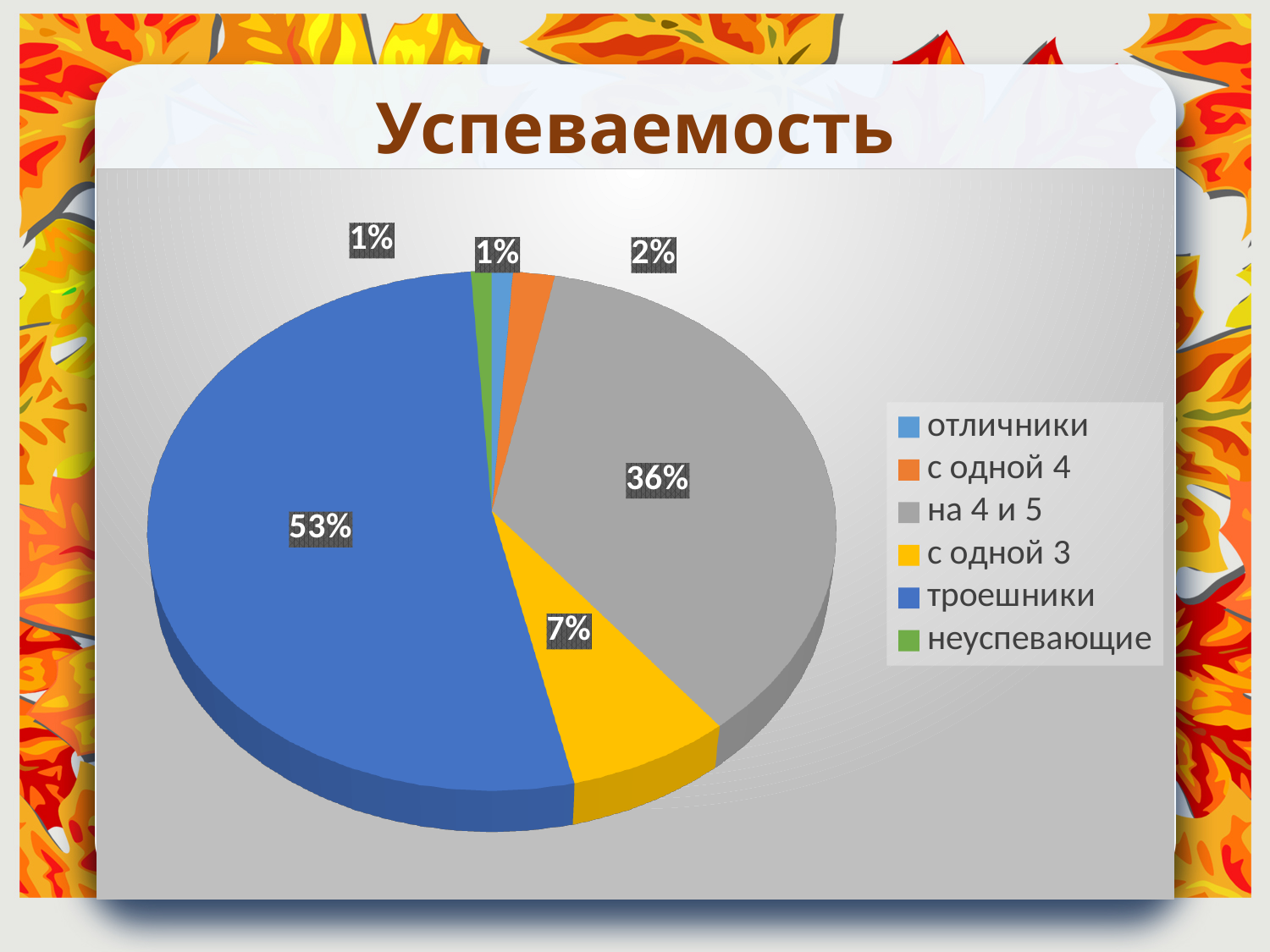
What share of the pie is "отличники"? 1% What share of the pie is "троешники"? 53% What share of the pie is "с одной 3"? 7% Which is larger, the slice for "на 4 и 5" or the slice for "с одной 3"? на 4 и 5 What is the difference between the shares of "троешники" and "на 4 и 5"? 17% How many categories does the legend list? 6 What colour is the slice for "с одной 3"? yellow What kind of chart is shown on the slide? pie chart What is the title of the chart? Успеваемость Which category has the largest slice? троешники